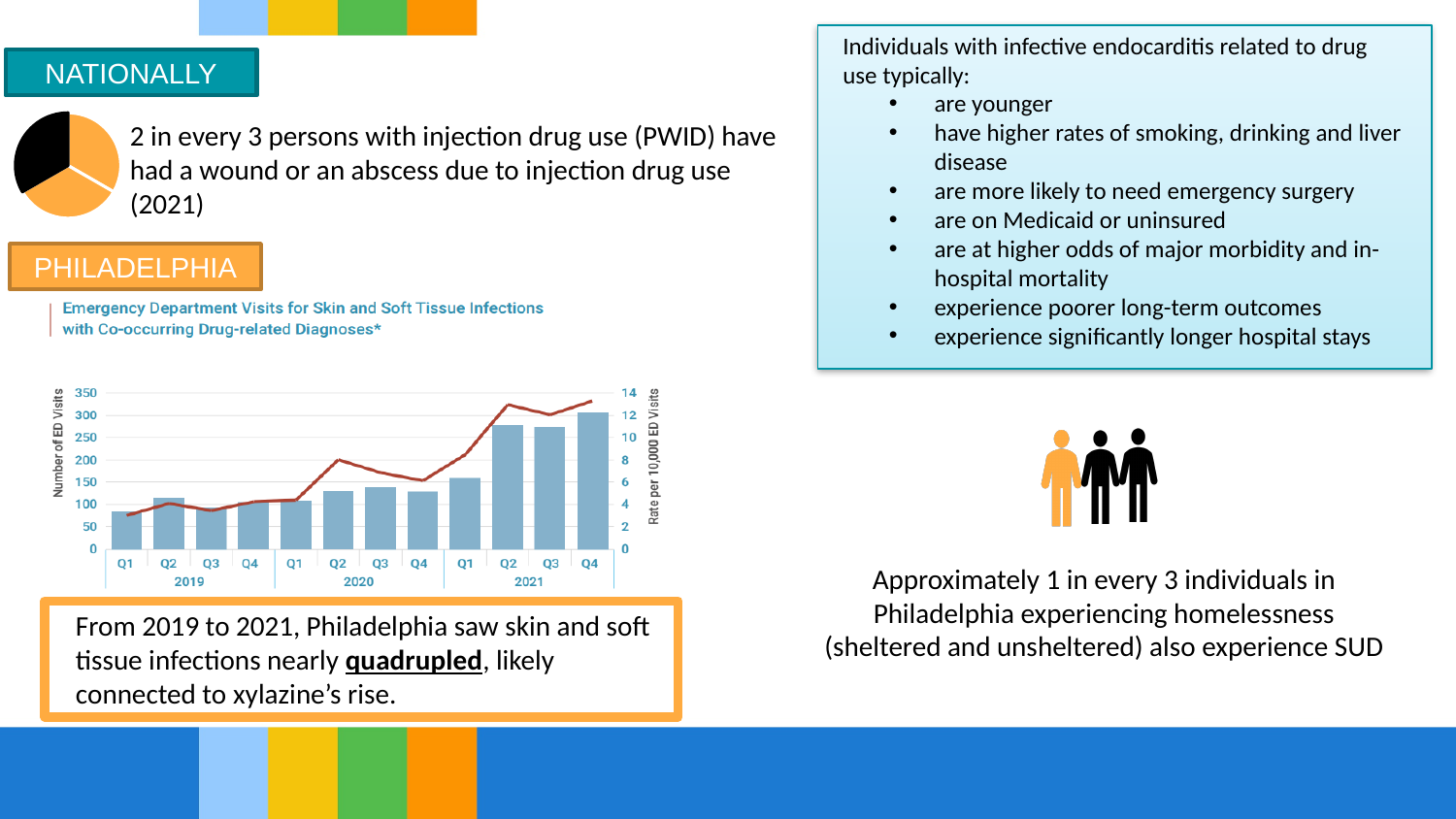
In the Emergency Department Visits chart, do the number of ED visits generally rise or fall from 2019 to 2021? Rise In the Emergency Department Visits chart, which quarter has the highest number of ED visits? Q4 2021 In the Emergency Department Visits chart, which has more ED visits: Q1 2021 or Q4 2021? Q4 2021 In the Emergency Department Visits chart, is the number of ED visits for Q4 2021 greater or less than 250? greater What is the label of the right vertical axis in the Emergency Department Visits chart? Rate per 10,000 ED Visits In the Emergency Department Visits chart, how many quarterly bars are plotted? 12 In the Emergency Department Visits chart, is the number of ED visits for Q2 2021 greater or less than 250? greater What type of chart is used to show Emergency Department Visits for Skin and Soft Tissue Infections on the slide? Bar chart with a line overlay What is the label of the left vertical axis in the Emergency Department Visits chart? Number of ED Visits In the Emergency Department Visits chart, is the number of ED visits for Q1 2019 greater or less than 100? less In the Emergency Department Visits chart, which has more ED visits: Q2 2019 or Q3 2019? Q2 2019